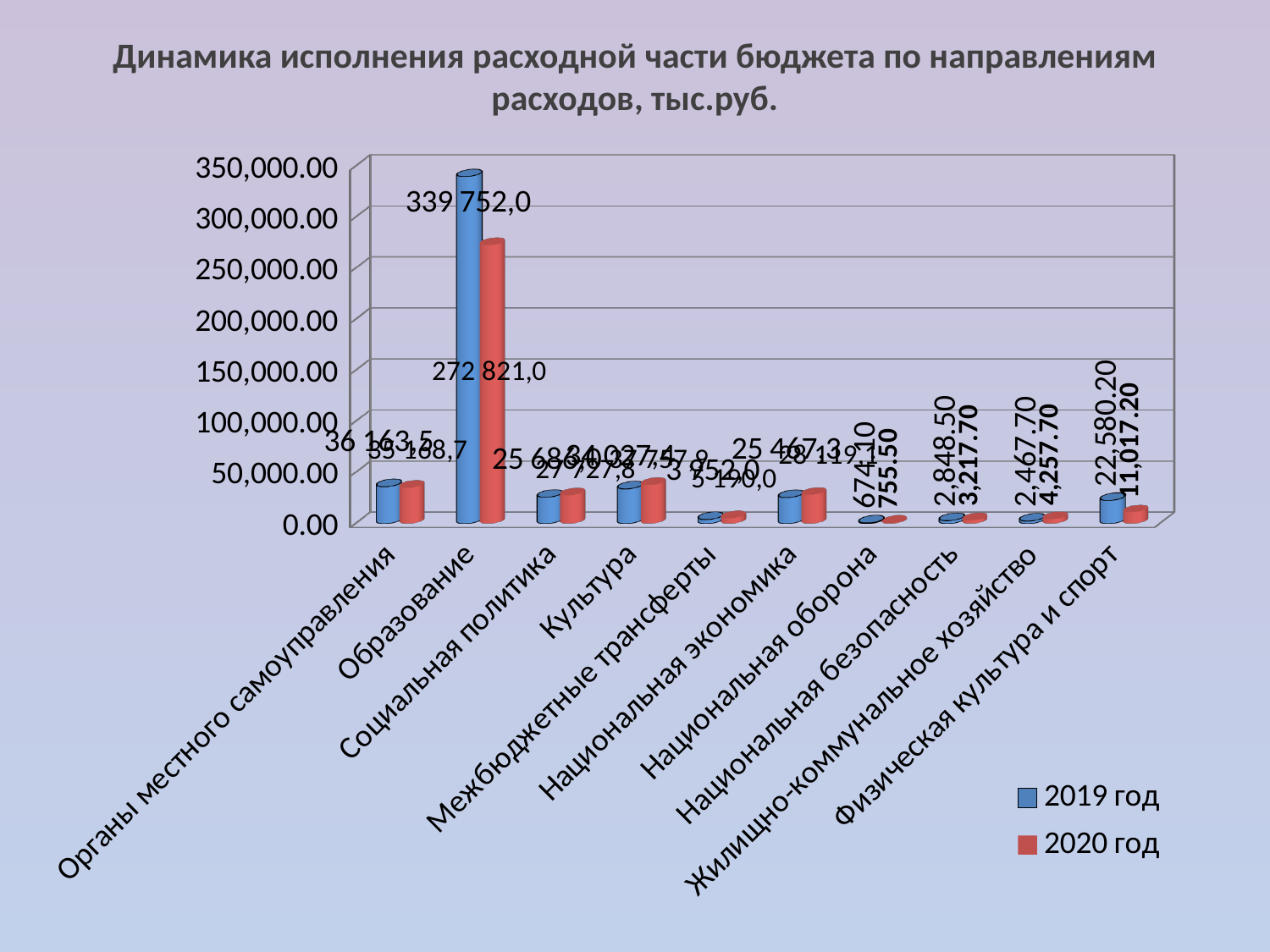
What is the value for Национальная оборона in 2020 год? 755.50 What is the difference between the 2019 год and 2020 год values for Образование? 66 931,0 What is the value for Образование in 2020 год? 272 821,0 What is the value for Образование in 2019 год? 339 752,0 What kind of chart is shown on the slide? bar chart How many series does the legend list? 2 How many expenditure categories are shown on the x axis? 10 Which category has the highest value for 2019 год? Образование Which year has the larger value for Физическая культура и спорт, 2019 год or 2020 год? 2019 год Which category has the lowest value for 2019 год? Национальная оборона Is the value for Образование in 2020 год greater or less than 250,000.00? greater What is the value for Жилищно-коммунальное хозяйство in 2020 год? 4,257.70